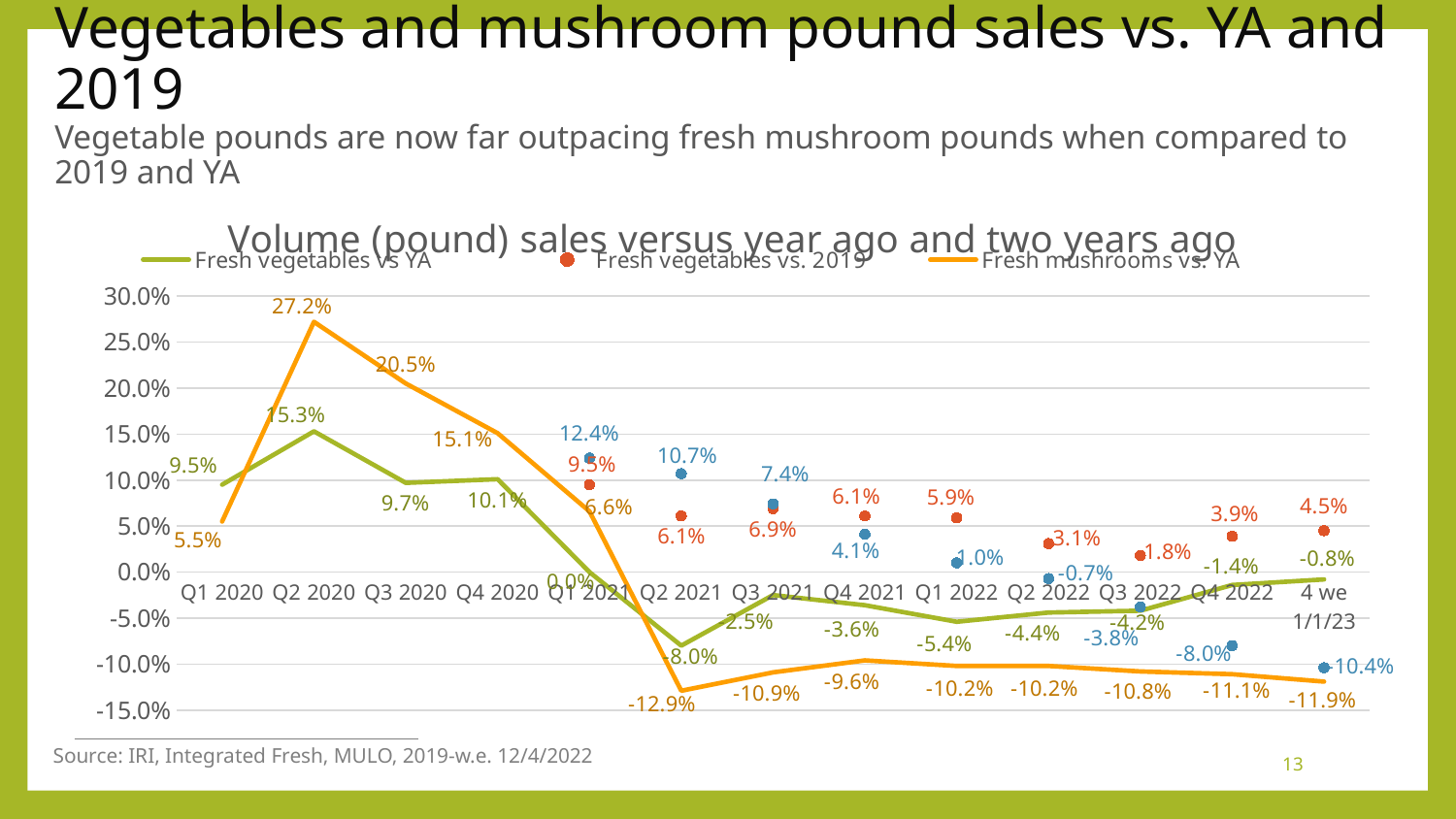
What is the value for Fresh mushrooms vs. YA in Q2 2020? 27.2% What kind of chart is shown on the slide? Line chart Does the Fresh mushrooms vs. YA line rise or fall from Q2 2020 to Q2 2021? Fall How many time periods are shown on the x axis? 13 In which period is Fresh mushrooms vs. YA at its lowest? Q2 2021 In which period is Fresh vegetables vs YA at its lowest? Q2 2021 In which period is Fresh mushrooms vs. YA at its highest? Q2 2020 What is the value for Fresh vegetables vs YA in Q2 2020? 15.3% What is the difference between Fresh mushrooms vs. YA and Fresh vegetables vs YA in Q2 2020? 11.9 percentage points How many series does the legend list? 3 In Q2 2021, which is higher: Fresh vegetables vs YA or Fresh mushrooms vs. YA? Fresh vegetables vs YA What is the value for Fresh vegetables vs. 2019 in Q1 2022? 5.9%